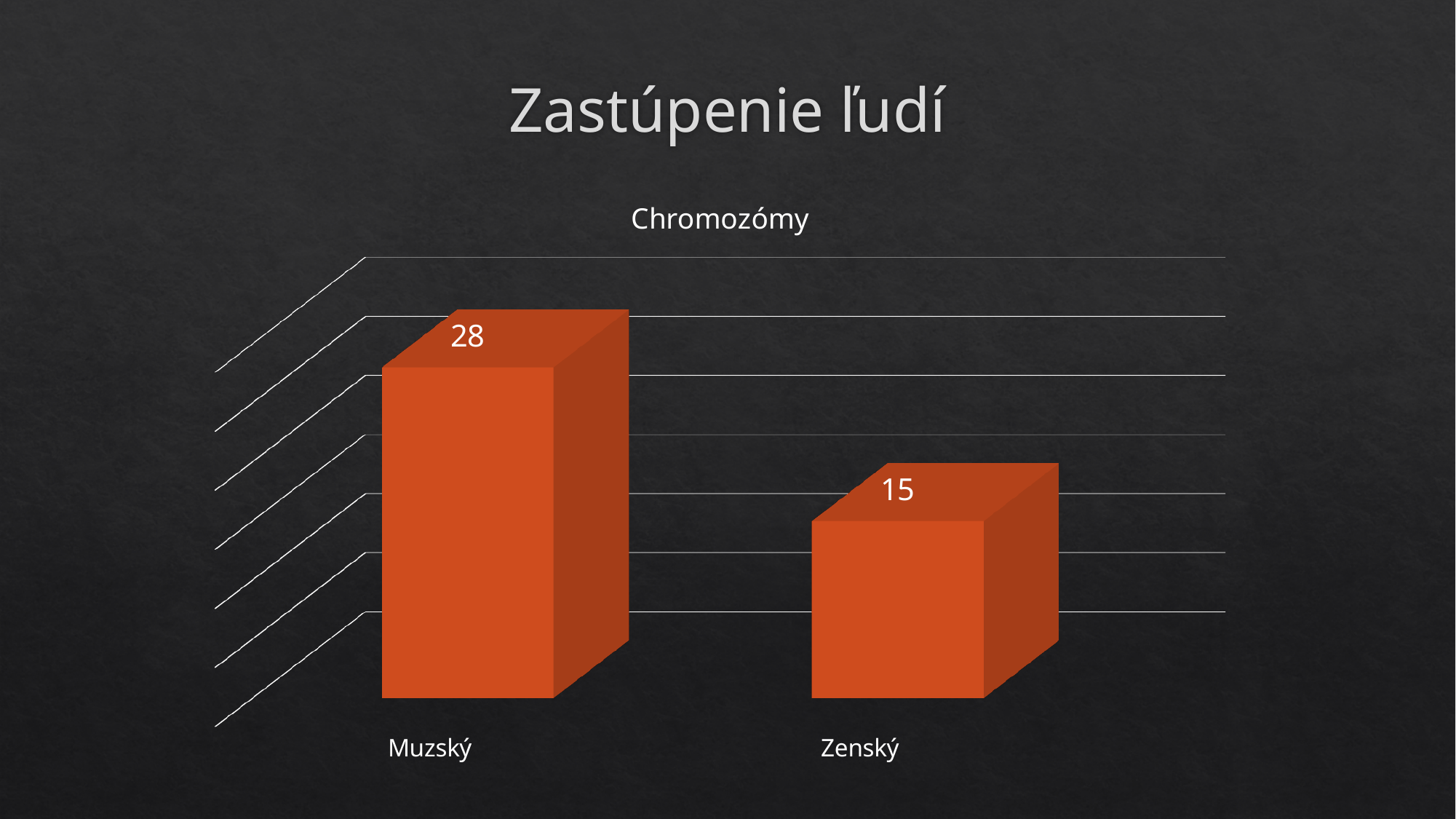
What is the title of the chart? Chromozómy What is the value for Zenský? 15 Which category has the highest value? Muzský What colour are the bars in the chart? Orange Which is larger, the value for Muzský or the value for Zenský? Muzský What is the total of the values for Muzský and Zenský? 43 What is the value for Muzský? 28 How many categories are shown in the chart? 2 What is the difference between the values for Muzský and Zenský? 13 Which category has the lowest value? Zenský What kind of chart is shown on the slide? Bar chart